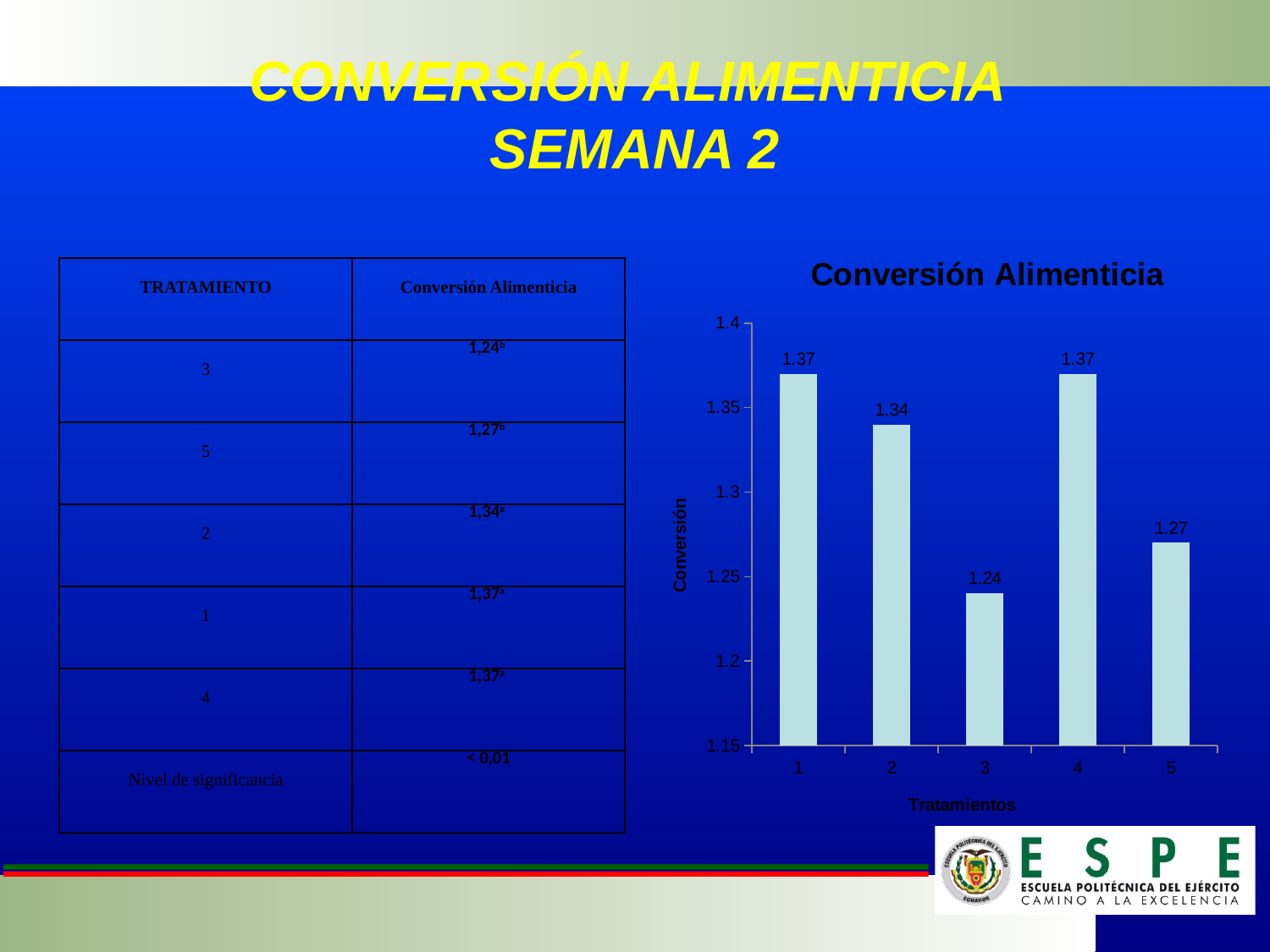
What is the difference between the values for treatment 1 and treatment 3 in the Conversión Alimenticia chart? 0.13 Is the value for treatment 3 in the Conversión Alimenticia chart greater or less than 1.25? less What is the difference between the values for treatment 2 and treatment 5 in the Conversión Alimenticia chart? 0.07 What is the value for treatment 1 in the Conversión Alimenticia chart? 1.37 What is the value for treatment 3 in the Conversión Alimenticia chart? 1.24 What kind of chart is the Conversión Alimenticia chart? Bar chart What is the label of the vertical axis in the Conversión Alimenticia chart? Conversión How many treatments are plotted in the Conversión Alimenticia chart? 5 Which has a larger value in the Conversión Alimenticia chart, treatment 2 or treatment 3? Treatment 2 What is the value for treatment 5 in the Conversión Alimenticia chart? 1.27 What is the label of the horizontal axis in the Conversión Alimenticia chart? Tratamientos Which treatment has the lowest value in the Conversión Alimenticia chart? 3